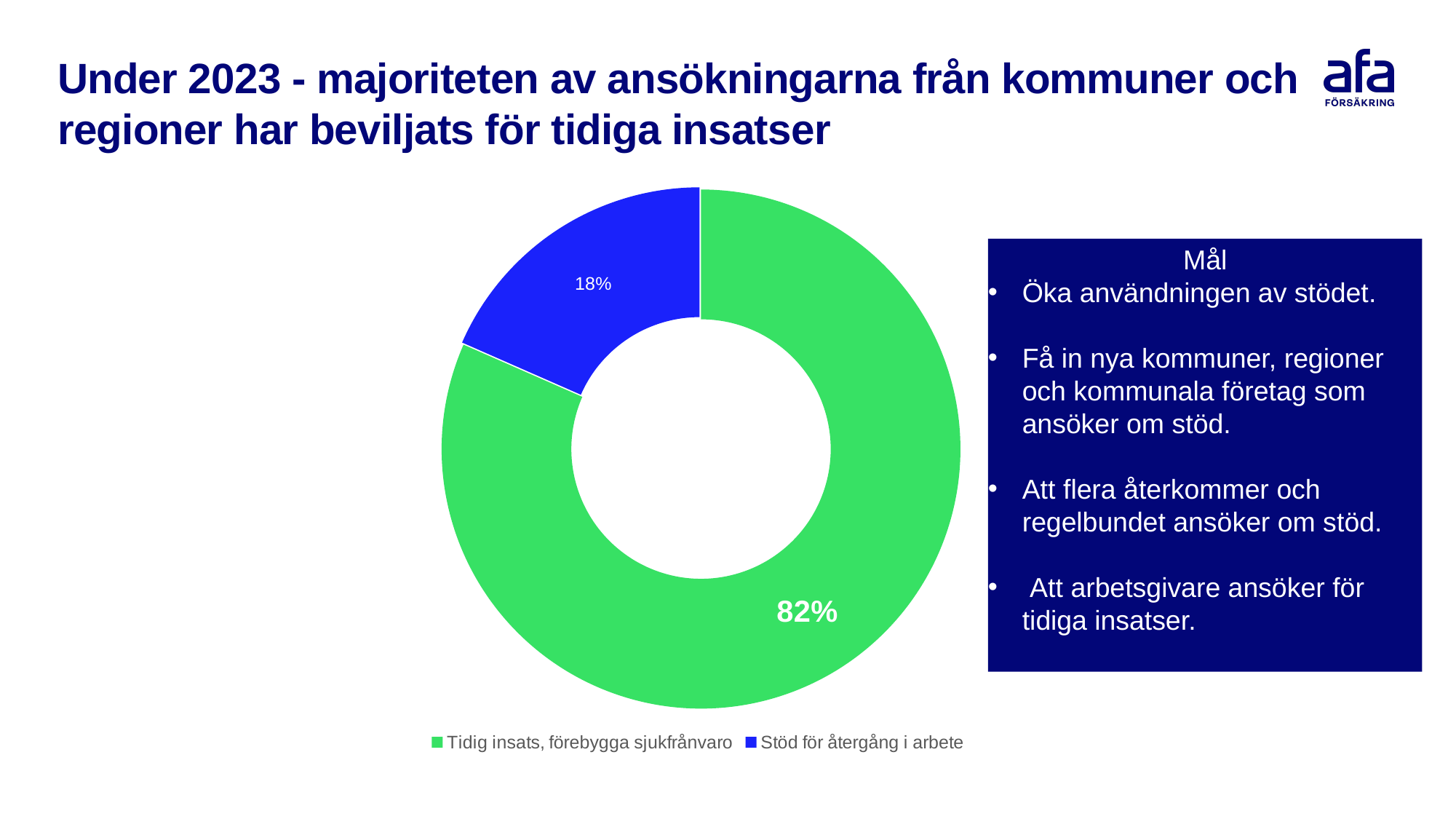
How many entries does the legend list? 2 How many categories does the chart show? 2 Which category has the smallest slice? Stöd för återgång i arbete What share of the pie does "Stöd för återgång i arbete" represent? 18% What is the difference in percentage points between the two slices? 64 What share of the pie does "Tidig insats, förebygga sjukfrånvaro" represent? 82% What is the value shown for the blue slice? 18% What colour is the slice for "Stöd för återgång i arbete"? Blue What kind of chart is shown on the slide? Pie chart (doughnut) Which category has the largest slice? Tidig insats, förebygga sjukfrånvaro Which is larger: "Tidig insats, förebygga sjukfrånvaro" or "Stöd för återgång i arbete"? Tidig insats, förebygga sjukfrånvaro What is the value shown for the green slice? 82%